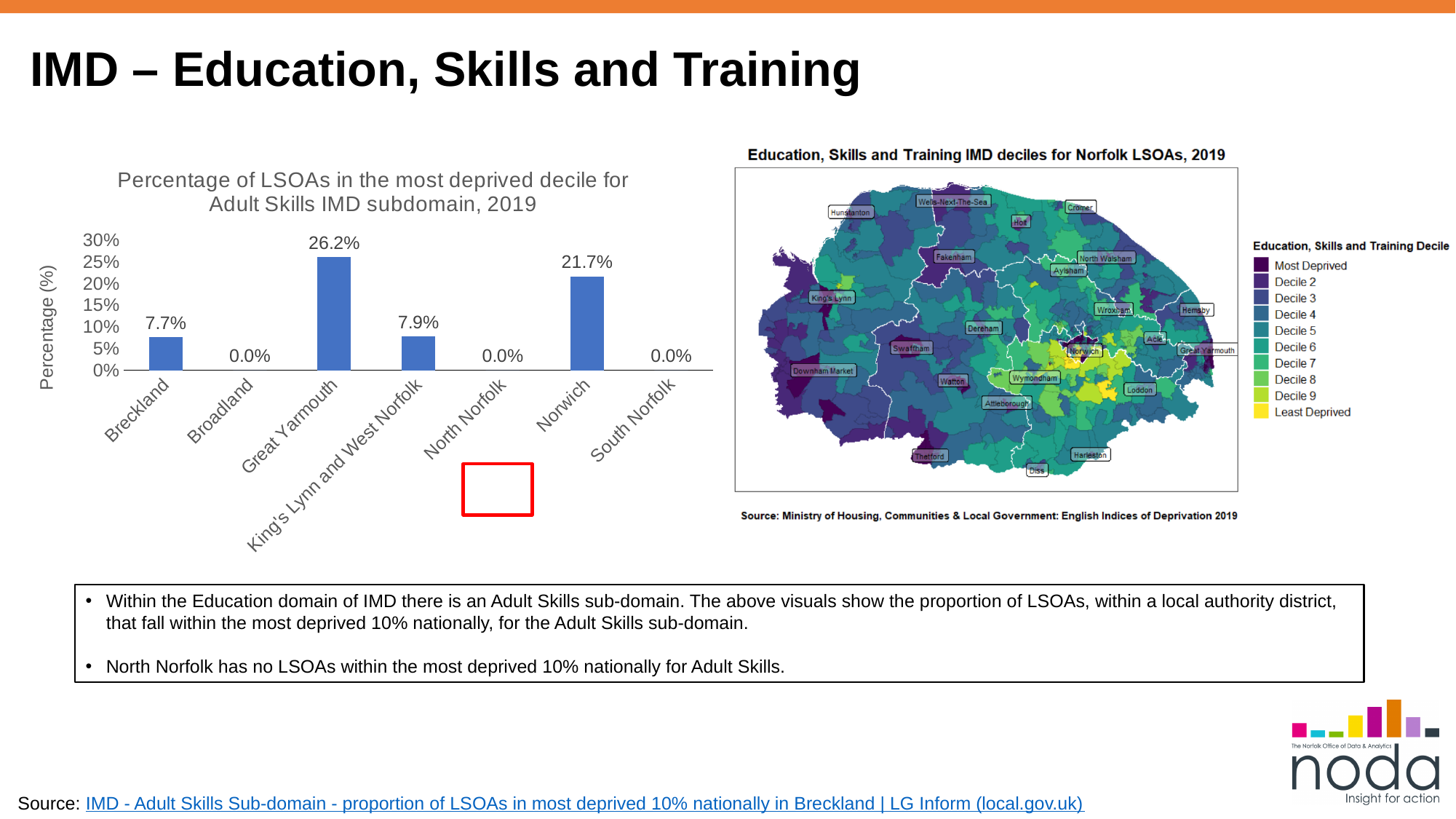
In the bar chart on the left, how many districts have a value of 0.0%? 3 In the bar chart on the left, what is the difference between the values for Great Yarmouth and Norwich? 4.5% What kind of chart is the chart on the left of the slide? bar chart In the bar chart on the left, which district has the highest percentage of LSOAs in the most deprived decile? Great Yarmouth In the bar chart on the left, what is the value for Norwich? 21.7% What is the y-axis label of the bar chart on the left? Percentage (%) In the bar chart on the left, what is the value for Breckland? 7.7% How many districts are shown in the bar chart on the left? 7 In the bar chart on the left, what is the value for King's Lynn and West Norfolk? 7.9% In the bar chart on the left, is the value for Great Yarmouth greater or less than 25%? greater In the bar chart on the left, which is larger, the value for Breckland or the value for Norwich? Norwich In the bar chart on the left, what is the value for Great Yarmouth? 26.2%